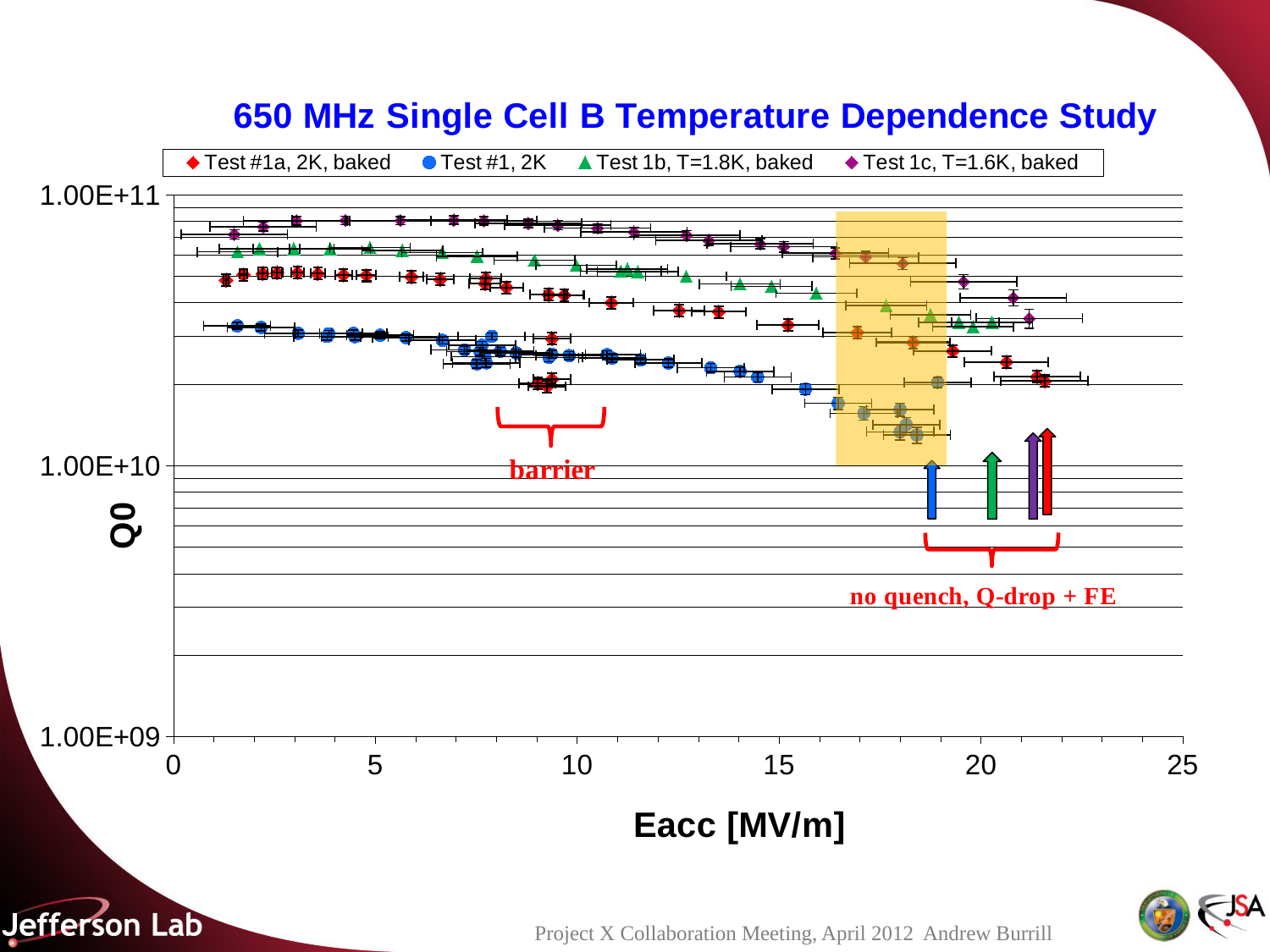
Is the highest Eacc reached by the Test #1a, 2K, baked series greater or less than 20 MV/m? greater What kind of chart is shown on the slide? scatter chart How many series does the legend list? 4 Which series has the highest Q0 values across the chart? Test 1c, T=1.6K, baked Does Q0 for the Test #1, 2K series rise or fall as Eacc increases? fall At low Eacc (around 5 MV/m), which series has the larger Q0: Test 1c, T=1.6K, baked or Test #1, 2K? Test 1c, T=1.6K, baked At Eacc around 5 MV/m, which series has the larger Q0: Test 1b, T=1.8K, baked or Test #1a, 2K, baked? Test 1b, T=1.8K, baked Is the Q0 value for Test #1, 2K at Eacc of about 5 MV/m greater or less than 1.00E+10? greater Which series has the lowest Q0 values across the chart? Test #1, 2K What label is shown on the x axis of the chart? Eacc [MV/m] Is the highest Eacc reached by the Test #1, 2K series greater or less than 20 MV/m? less What is the title of the chart? 650 MHz Single Cell B Temperature Dependence Study